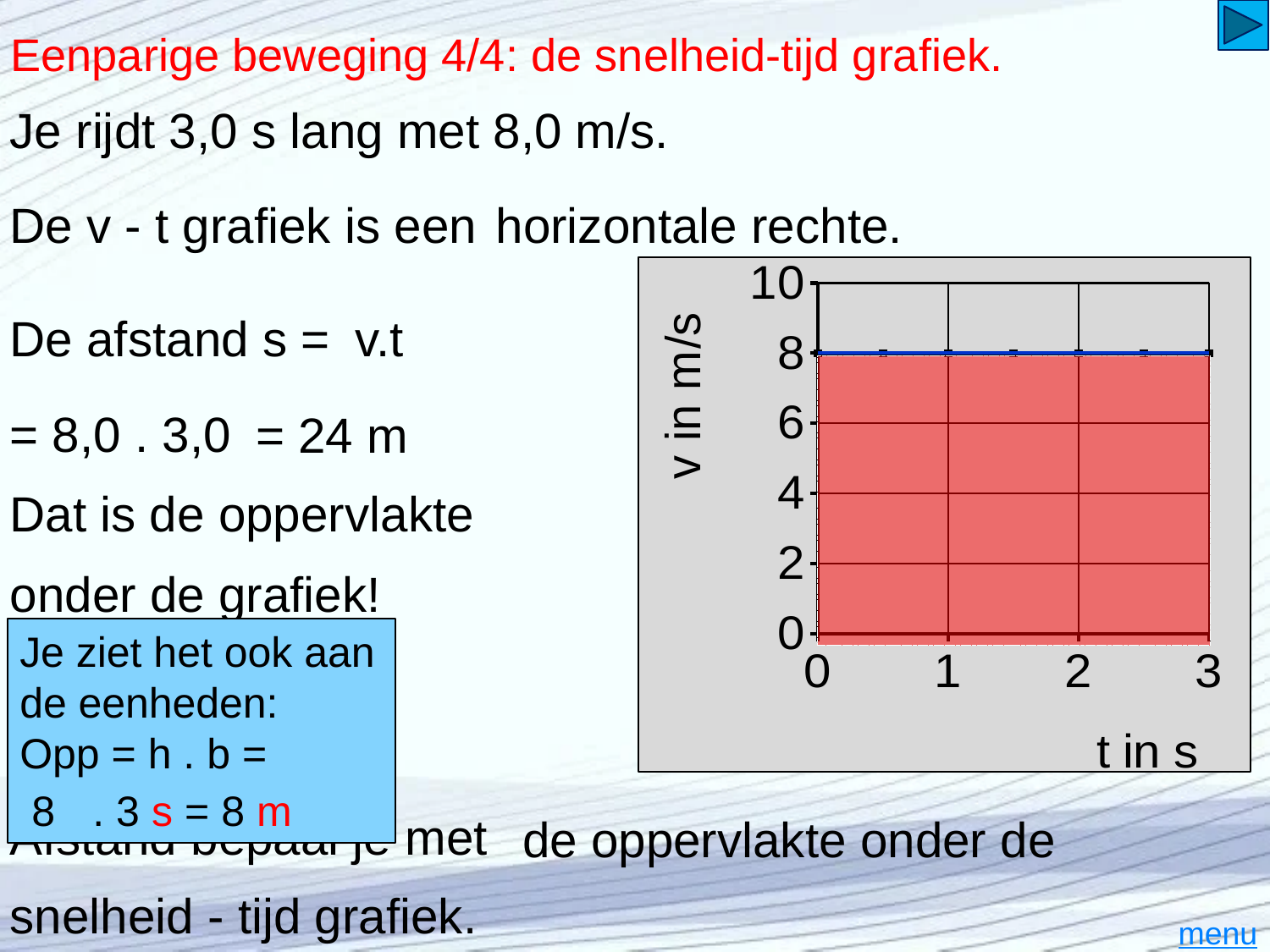
What is the value of v at t = 3 s on the chart? 8 What is the label of the horizontal axis of the chart? t in s What is the highest tick value shown on the vertical axis? 10 What kind of chart is shown on the slide? line chart What is the highest tick value shown on the horizontal axis? 3 How many tick labels are shown on the horizontal axis? 4 Does the plotted line rise, fall, or stay constant as t increases from 0 to 3 s? stays constant What is the value of v at t = 1 s on the chart? 8 Is the plotted value of v at t = 2 s greater or less than 6? greater Is the value of v at t = 1 s larger than, smaller than, or equal to the value at t = 3 s? equal Is the plotted value of v at t = 0 s greater or less than 10? less What is the label of the vertical axis of the chart? v in m/s